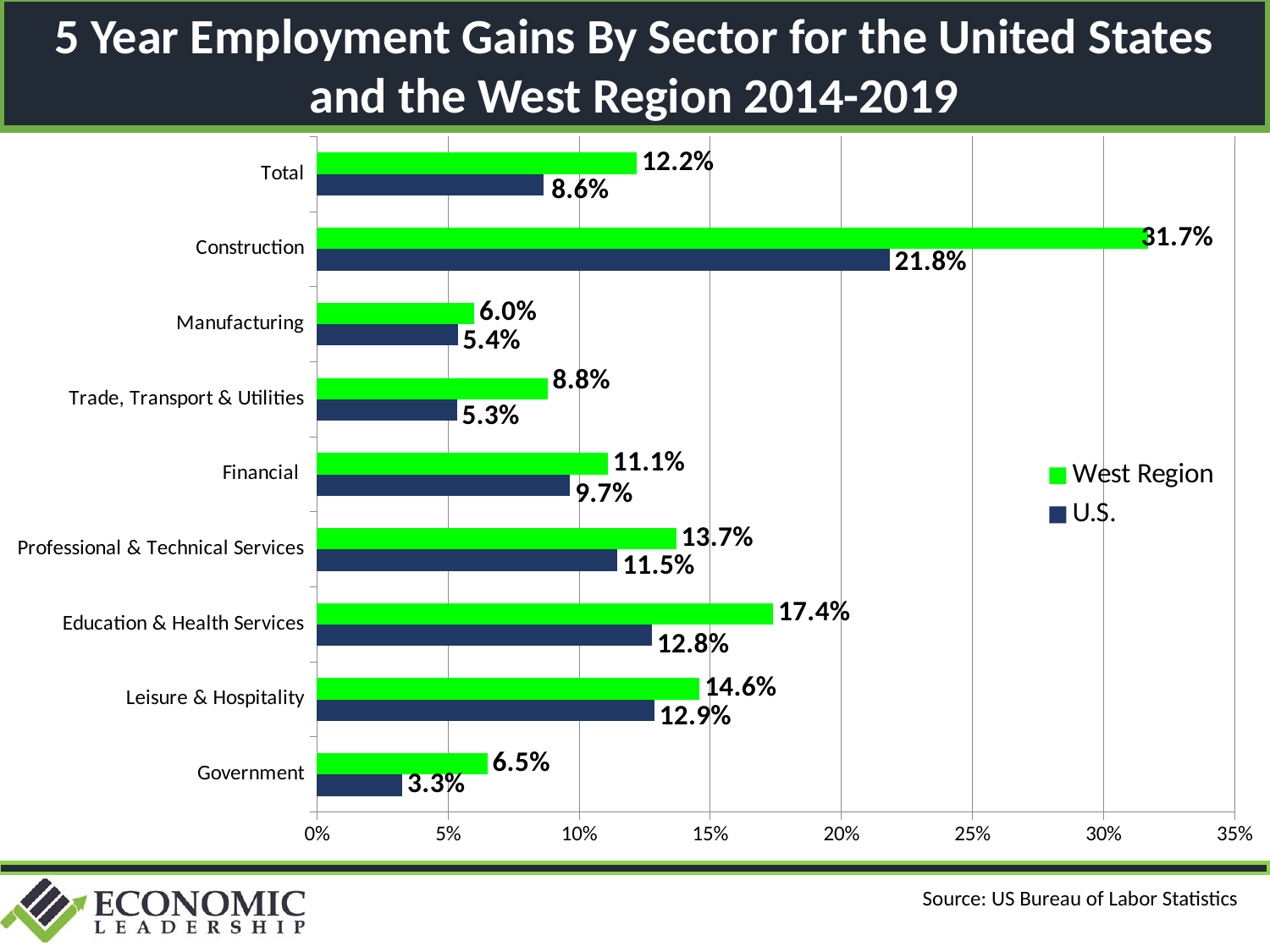
What kind of chart is shown on the slide? bar chart What is the U.S. value for Government? 3.3% What colour represents the West Region series? green How many series does the legend list? 2 What is the difference between the West Region and U.S. values for Construction? 9.9% How many categories are shown on the chart? 9 Which sector has the highest West Region value? Construction Is the U.S. value for Construction greater or less than 20%? greater Which is larger for Leisure & Hospitality, the West Region value or the U.S. value? West Region What is the West Region value for Construction? 31.7% What is the U.S. value for Education & Health Services? 12.8% Which sector has the lowest U.S. value? Government